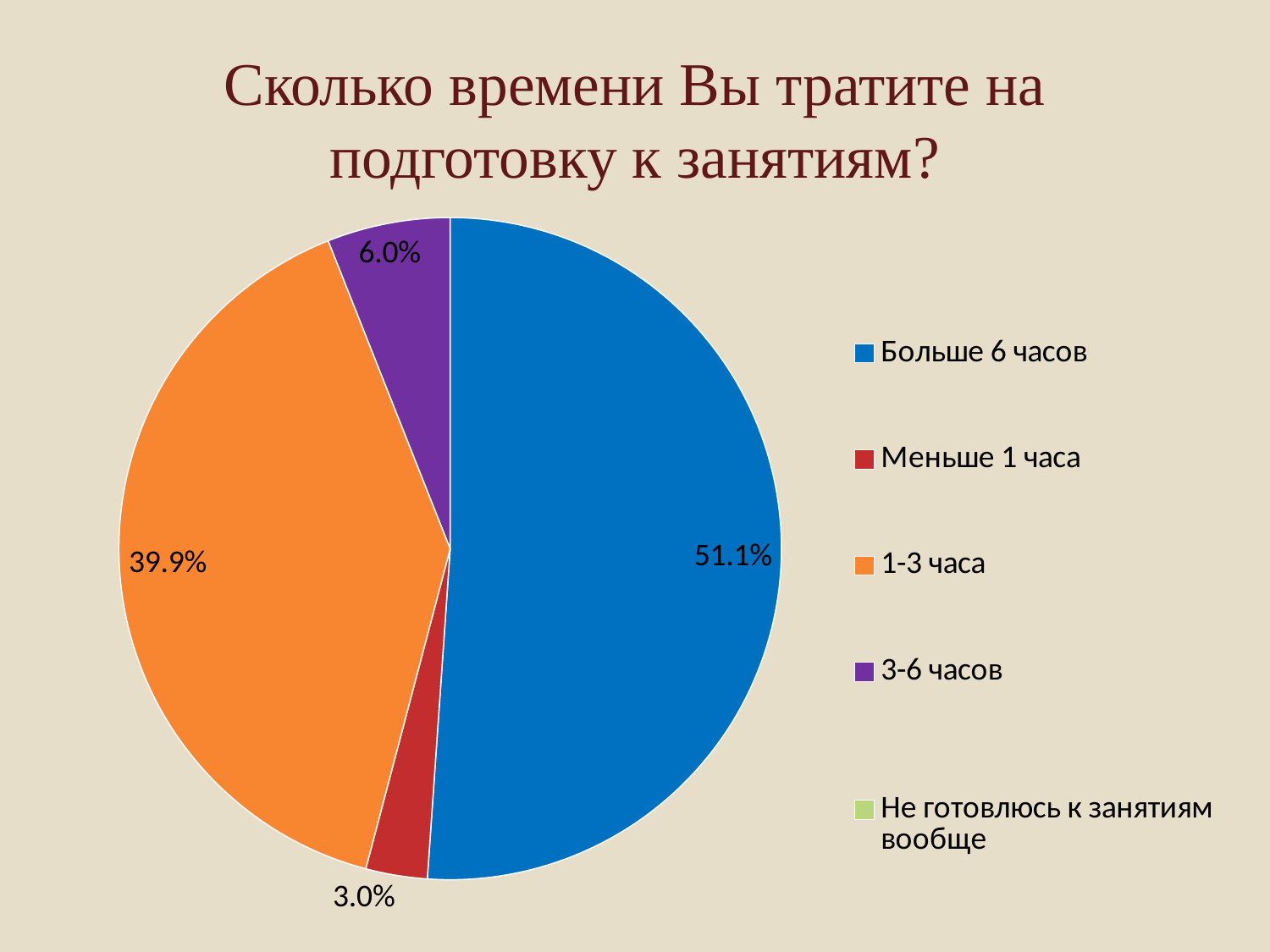
What type of chart is shown on the slide? Pie chart What colour represents the 1-3 часа category in the pie chart? Orange What percentage is shown for the 3-6 часов category? 6.0% What percentage of respondents spend more than 6 hours (Больше 6 часов) preparing for classes? 51.1% What is the title of the chart? Сколько времени Вы тратите на подготовку к занятиям? Which slice is larger: 3-6 часов or Меньше 1 часа? 3-6 часов Among the slices with printed labels, which category has the smallest share? Меньше 1 часа What is the difference in percentage points between the Больше 6 часов and 1-3 часа slices? 11.2 percentage points Which category has the largest slice of the pie? Больше 6 часов How many categories are listed in the legend? 5 What percentage is shown for the Меньше 1 часа category? 3.0% What percentage is shown for the 1-3 часа category? 39.9%